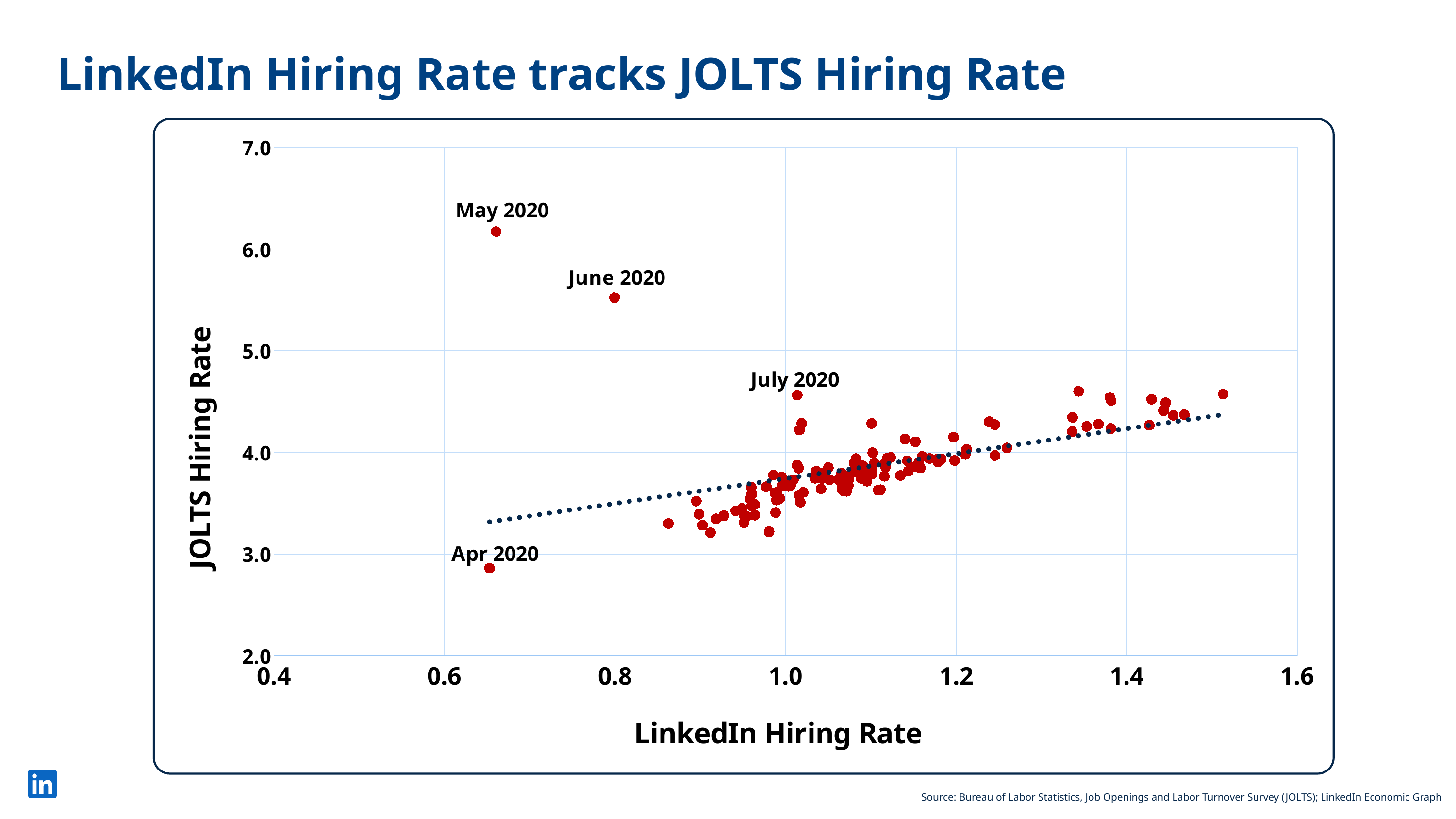
How many data points are labeled with a month and year on the chart? 4 Is the JOLTS Hiring Rate for May 2020 greater or less than 6.0? greater Is the JOLTS Hiring Rate for July 2020 greater or less than 4.0? greater Which labeled point has the highest JOLTS Hiring Rate? May 2020 Which has a higher JOLTS Hiring Rate, June 2020 or July 2020? June 2020 What is the label of the vertical axis? JOLTS Hiring Rate Is the JOLTS Hiring Rate for Apr 2020 greater or less than 3.0? less What is the title of the chart on the slide? LinkedIn Hiring Rate tracks JOLTS Hiring Rate Which labeled point has the lowest JOLTS Hiring Rate? Apr 2020 Does the dotted trend line rise or fall as the LinkedIn Hiring Rate increases? rise What kind of chart is shown on the slide? scatter chart